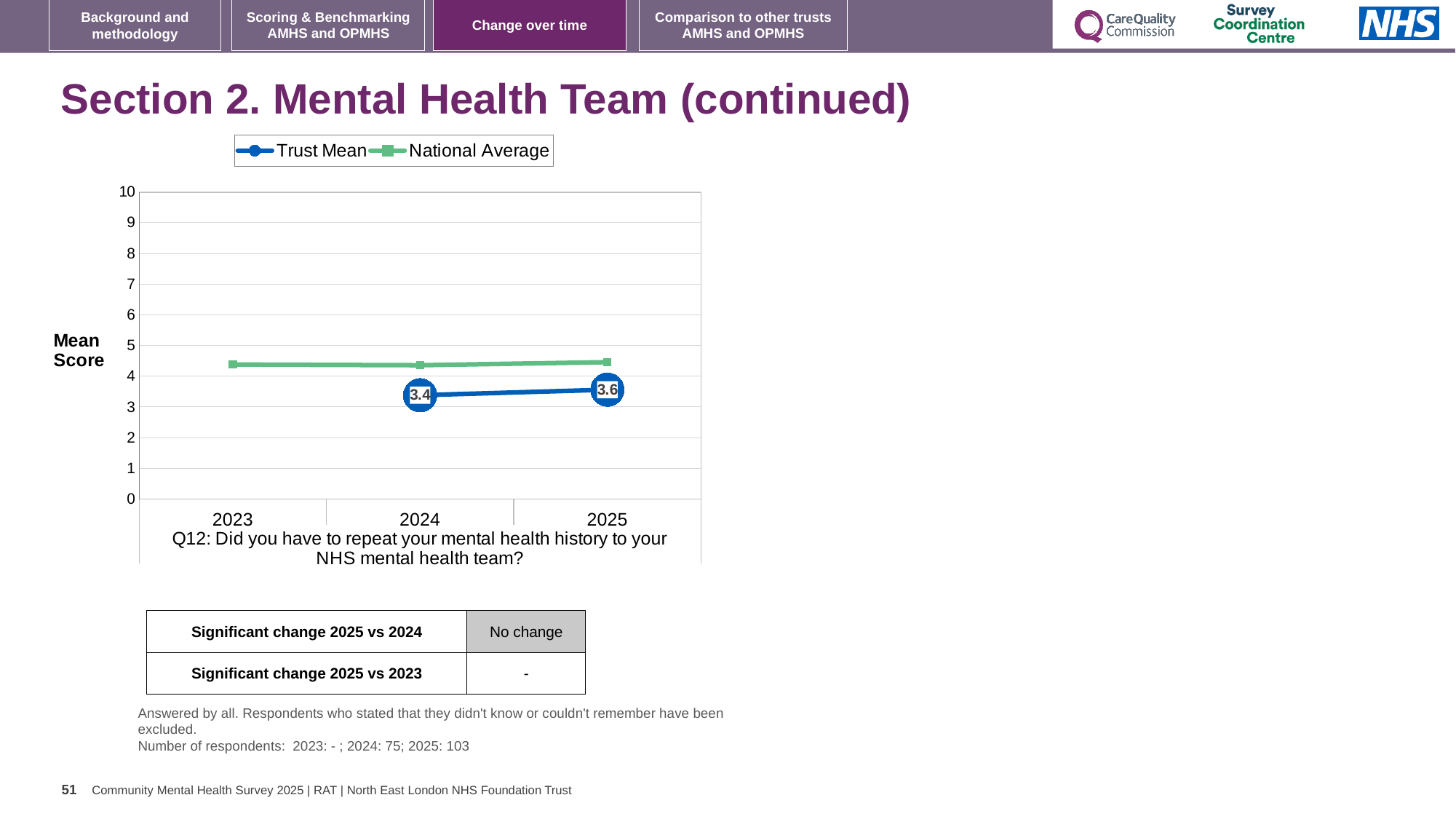
Does the Trust Mean rise or fall from 2024 to 2025? rise What is the difference between the Trust Mean in 2025 and in 2024? 0.2 How many years are shown on the x axis of the chart? 3 Which year has the higher Trust Mean, 2024 or 2025? 2025 What is the Trust Mean value for 2025? 3.6 How many series does the chart legend list? 2 Is the National Average value for 2025 greater or less than 4? greater In 2025, which series has the higher value, Trust Mean or National Average? National Average Is the National Average value for 2023 greater or less than 5? less What kind of chart is shown on the slide? line chart What is the Trust Mean value for 2024? 3.4 What is the label on the y axis of the chart? Mean Score